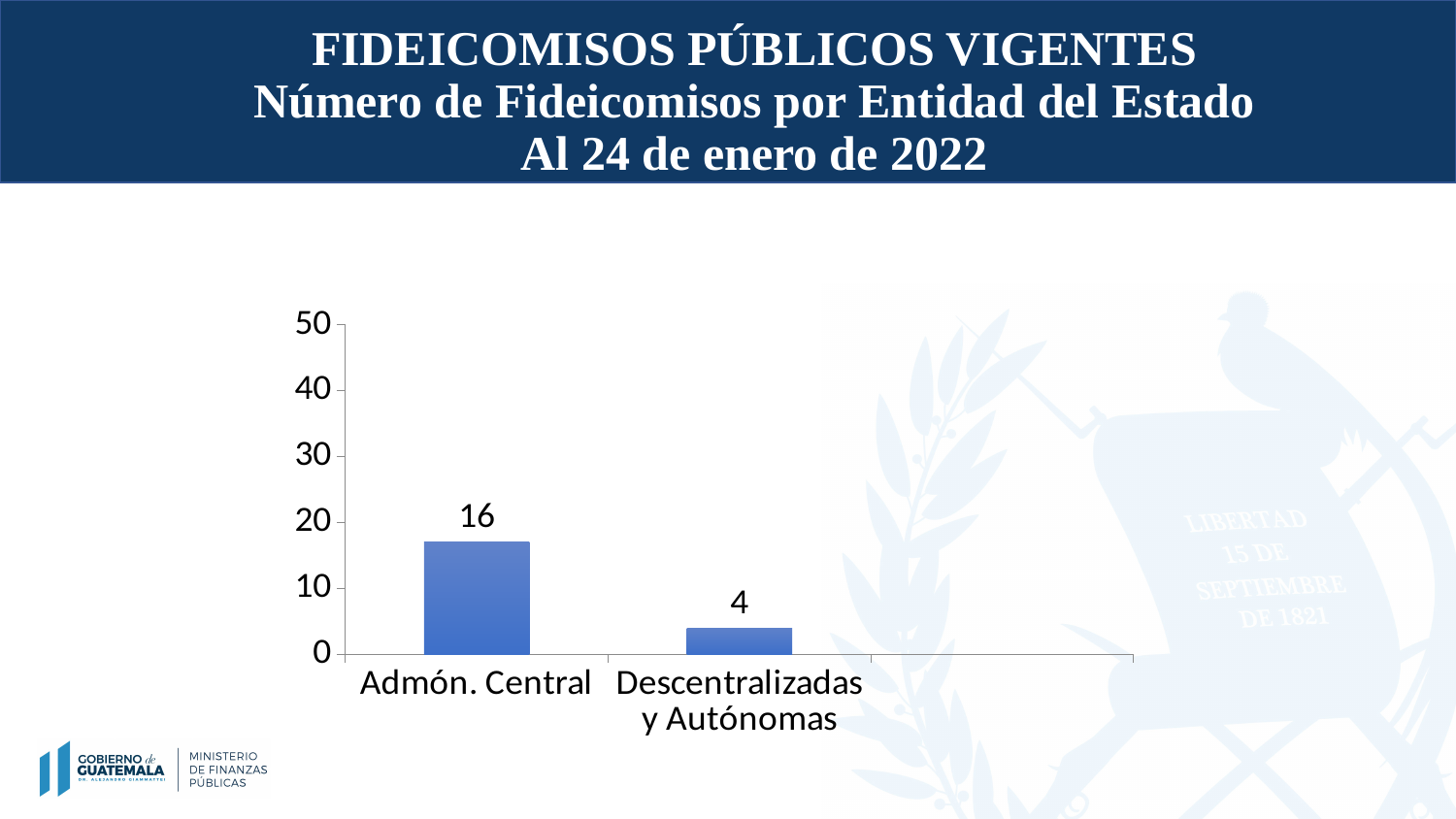
What kind of chart is shown on the slide? Bar chart How many categories are shown in the chart? 2 Which category has the lowest number of fideicomisos? Descentralizadas y Autónomas Is the value for Descentralizadas y Autónomas greater or less than 10? less What is the number of fideicomisos for Admón. Central? 16 Is the value for Admón. Central greater or less than 20? less What is the maximum value shown on the vertical axis? 50 What is the number of fideicomisos for Descentralizadas y Autónomas? 4 Which is larger, the value for Admón. Central or the value for Descentralizadas y Autónomas? Admón. Central Which category has the highest number of fideicomisos? Admón. Central As of what date does the chart report the number of fideicomisos? 24 de enero de 2022 What is the difference between the values for Admón. Central and Descentralizadas y Autónomas? 12